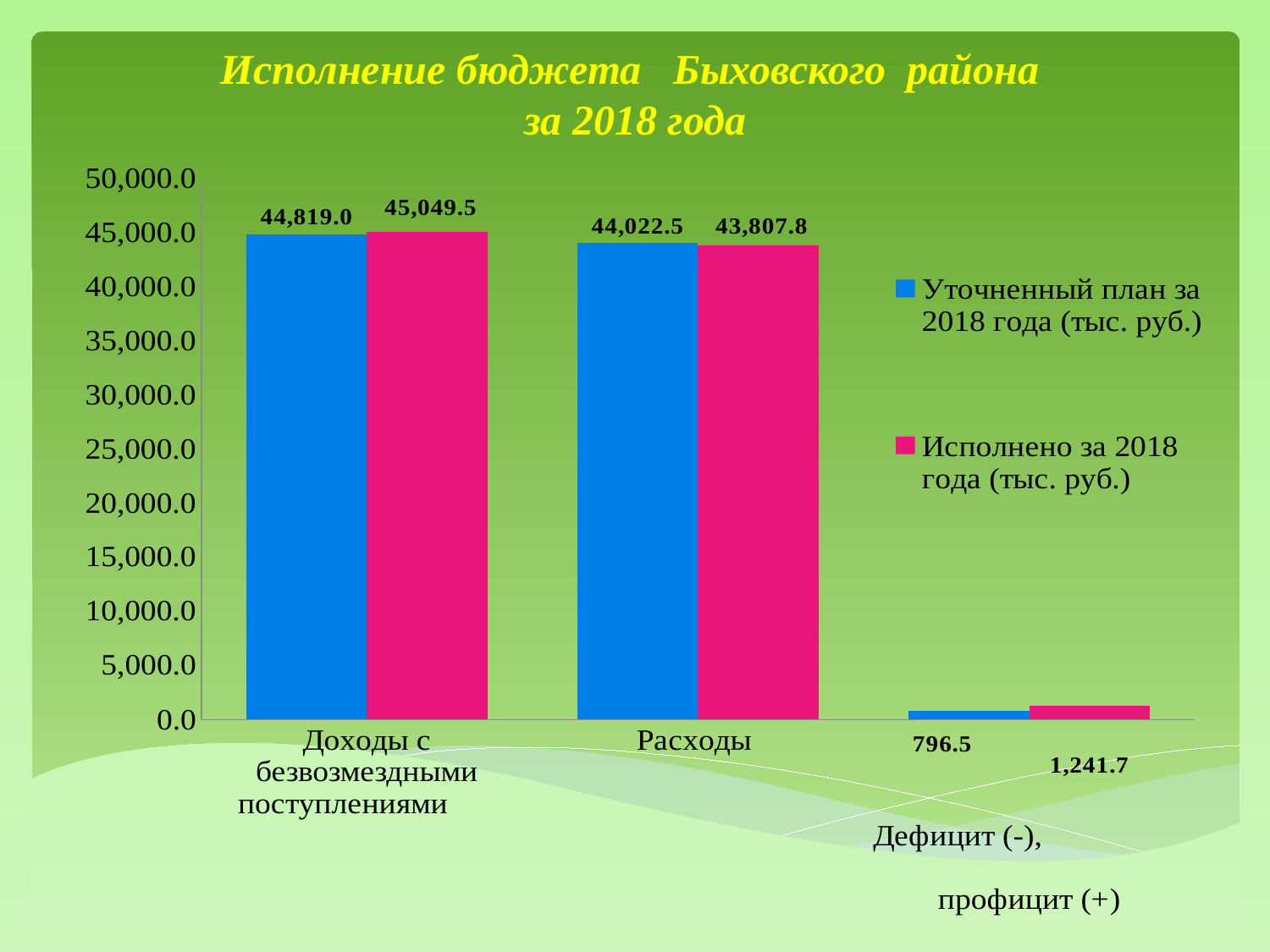
What is the value of 'Исполнено за 2018 года (тыс. руб.)' for 'Расходы'? 43,807.8 Which category has the lowest values in the chart? Дефицит (-), профицит (+) Which series has the higher value for 'Доходы с безвозмездными поступлениями'? Исполнено за 2018 года (тыс. руб.) What is the difference between the executed and planned values for 'Доходы с безвозмездными поступлениями'? 230.5 What is the value of 'Исполнено за 2018 года (тыс. руб.)' for 'Дефицит (-), профицит (+)'? 1,241.7 Which series has the higher value for 'Расходы'? Уточненный план за 2018 года (тыс. руб.) How many series does the legend list? 2 What is the difference between the planned and executed values for 'Расходы'? 214.7 What colour are the bars for 'Исполнено за 2018 года (тыс. руб.)'? pink What type of chart is shown on the slide? bar chart What is the value of 'Уточненный план за 2018 года (тыс. руб.)' for 'Доходы с безвозмездными поступлениями'? 44,819.0 How many categories are shown on the x axis? 3